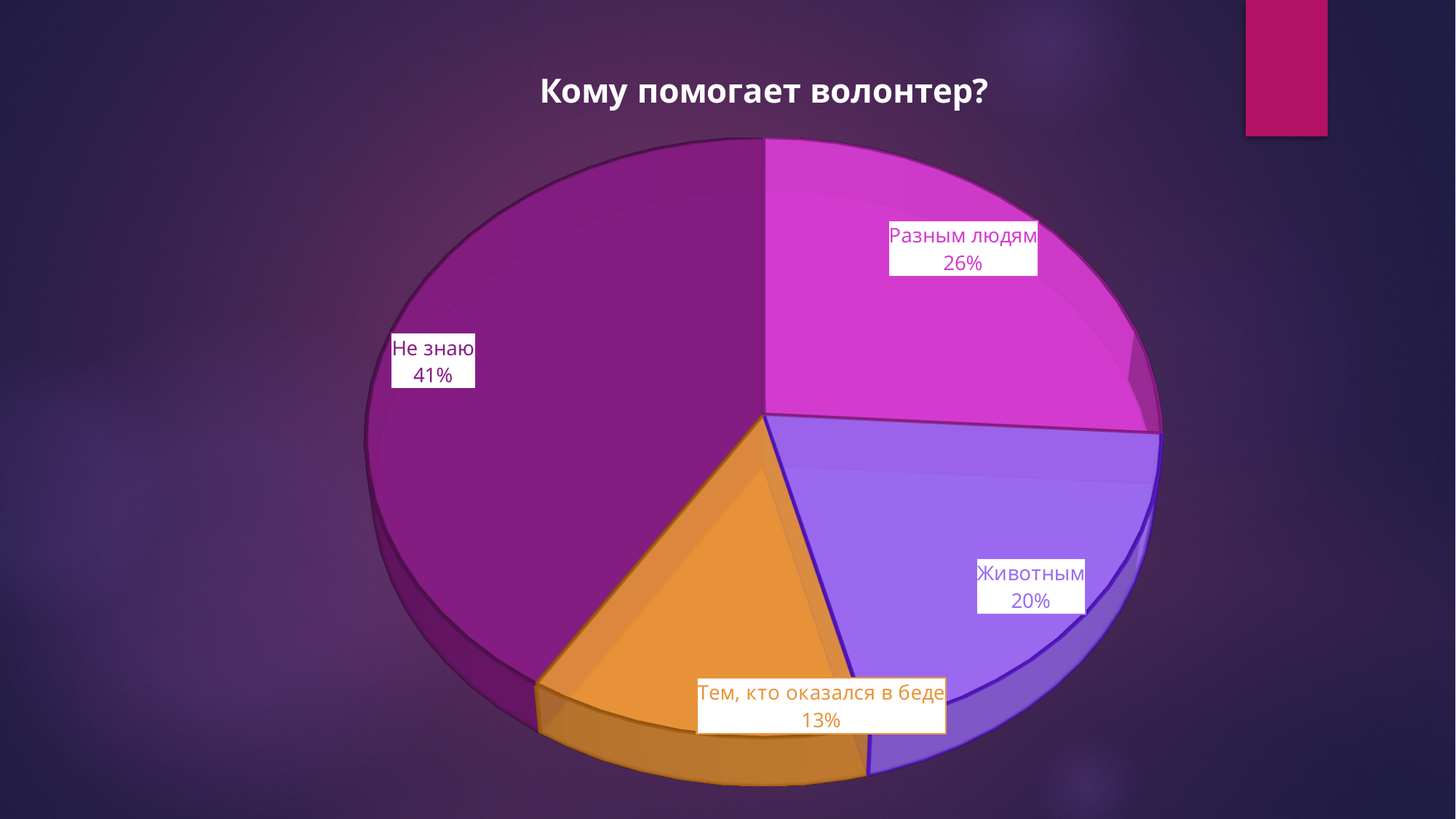
What percentage is shown for "Животным"? 20% Which category has the largest share of the pie? Не знаю What is the title of the chart? Кому помогает волонтер? Which is larger: the share for "Животным" or the share for "Тем, кто оказался в беде"? Животным What percentage is shown for "Тем, кто оказался в беде"? 13% What percentage is shown for "Разным людям"? 26% Which category has the smallest share of the pie? Тем, кто оказался в беде What colour is the slice for "Тем, кто оказался в беде"? orange What is the difference in percentage points between "Не знаю" and "Разным людям"? 15 What percentage is shown for "Не знаю"? 41% How many slices does the pie chart have? 4 What kind of chart is shown on the slide? pie chart